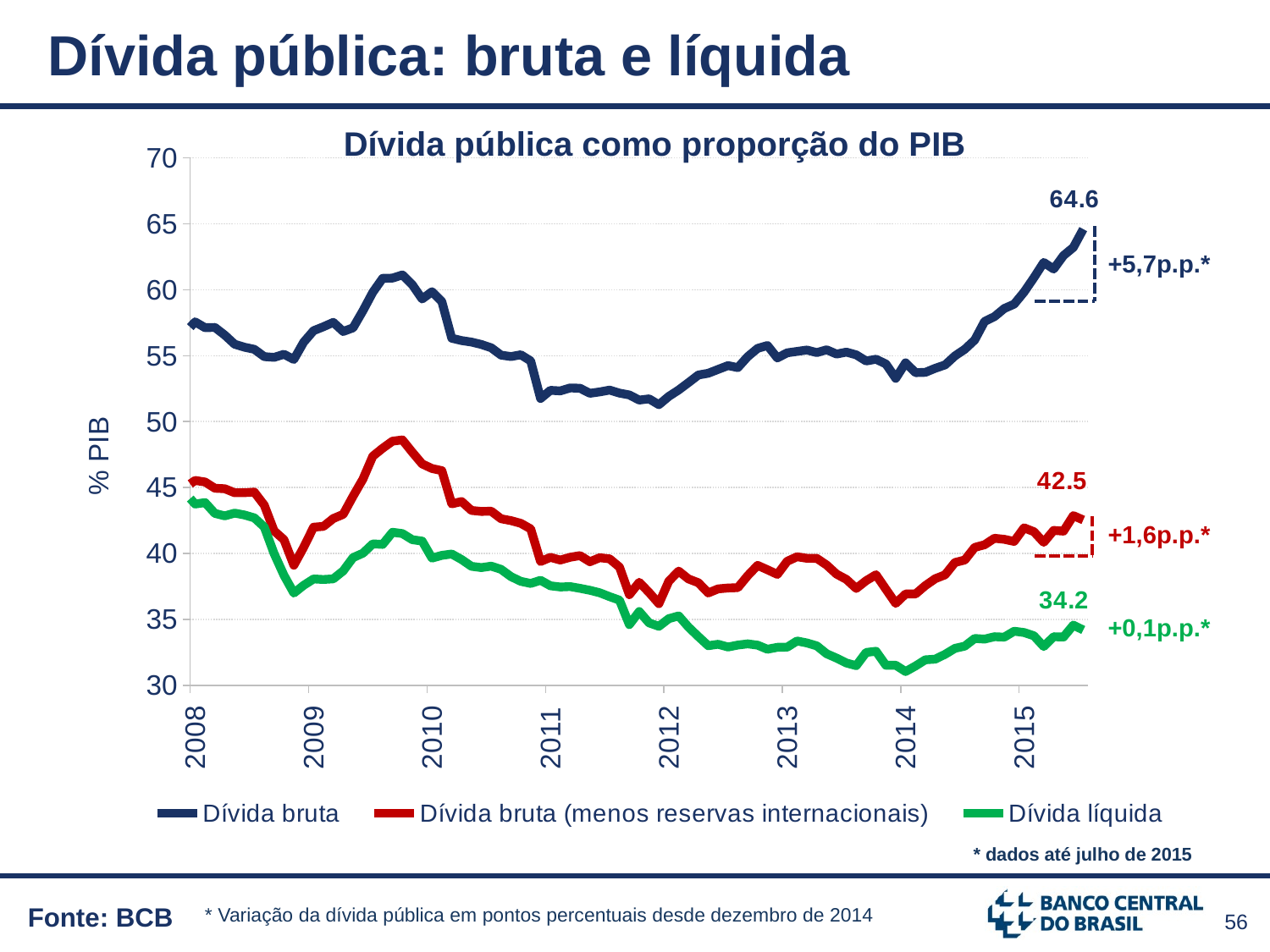
What is the difference between the latest labelled values of Dívida bruta (menos reservas internacionais) and Dívida líquida? 8.3 What is the latest labelled value for Dívida bruta? 64.6 Which series has the highest value across the whole period? Dívida bruta What is the difference between the latest labelled values of Dívida bruta and Dívida líquida? 30.4 How many series does the legend list? 3 What is the latest labelled value for Dívida bruta (menos reservas internacionais)? 42.5 What is the title of the chart? Dívida pública como proporção do PIB What is the latest labelled value for Dívida líquida? 34.2 Is the value for Dívida bruta at the start of 2012 greater or less than 55? less Does Dívida bruta rise or fall between the start of 2014 and the end of the series? rise What kind of chart is shown on the slide? line chart Which series has the lowest value at the end of the period? Dívida líquida